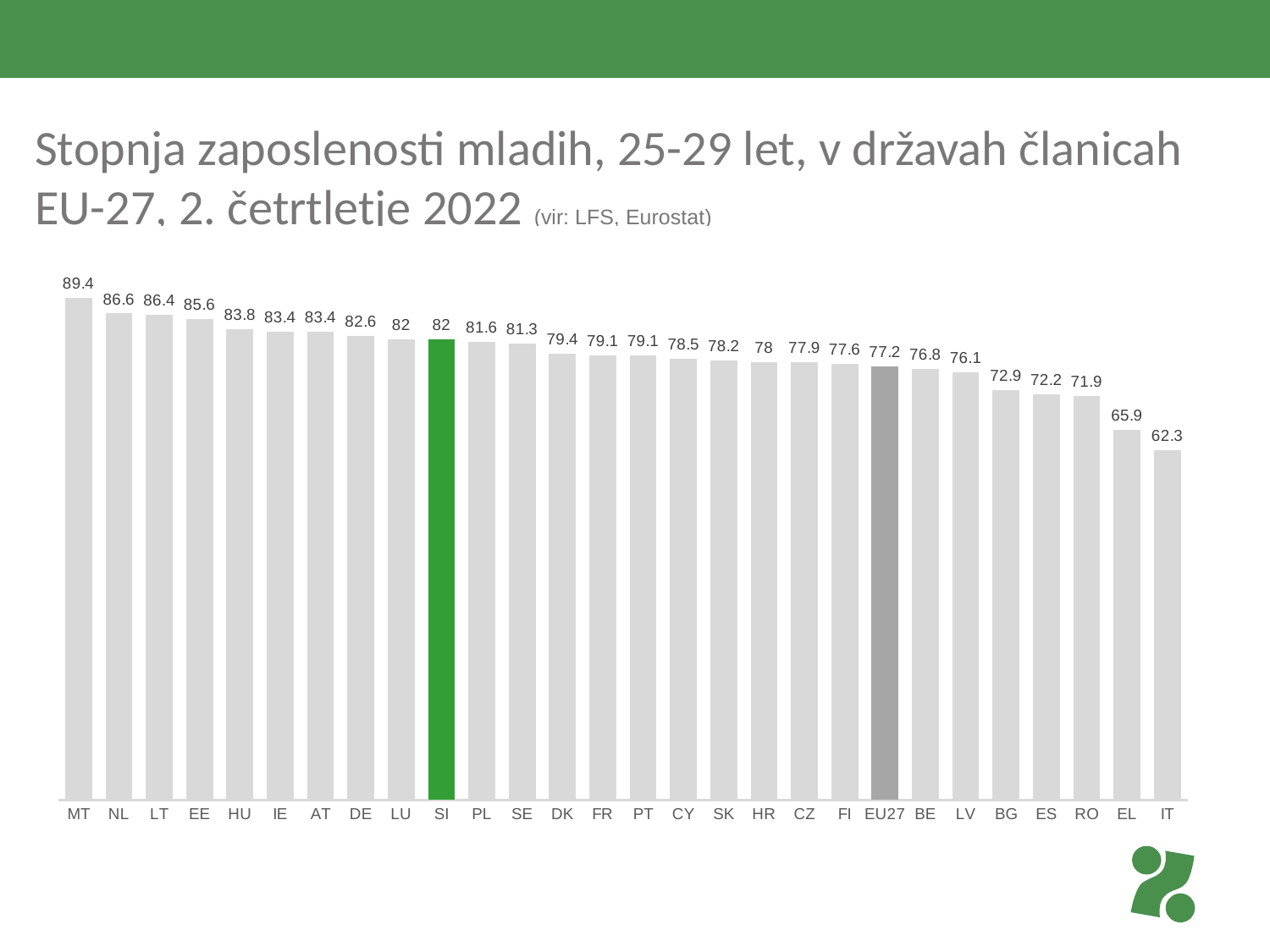
What is the value for DK? 79.4 What kind of chart is shown on the slide? Bar chart Which has a larger value, BE or LV? BE What is the value for SI? 82 Which bar is highlighted in green? SI What is the value for EU27? 77.2 What is the difference between the values for MT and IT? 27.1 Which category has the highest value? MT How many bars are shown in the chart? 28 Do the values rise or fall from left to right along the x axis? Fall What is the difference between the values for SI and EU27? 4.8 Which category has the lowest value? IT